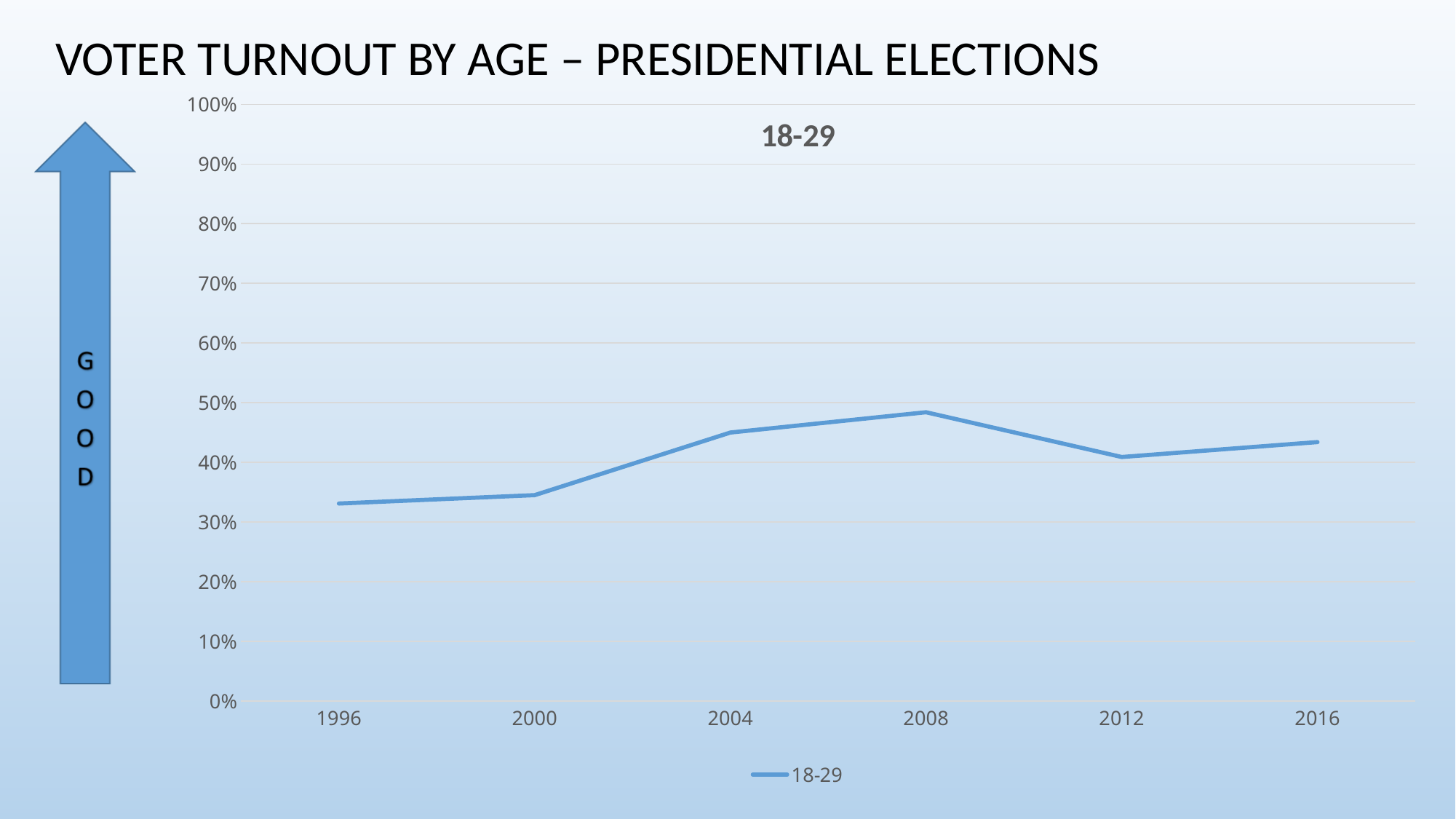
Which election year has the highest voter turnout for the 18-29 group? 2008 Does voter turnout rise or fall from 1996 to 2008? rise Which year has the higher voter turnout, 2012 or 2016? 2016 What age group does the chart's series represent? 18-29 Is the voter turnout for 2008 greater or less than 50%? less Is the voter turnout for 2004 greater or less than 40%? greater Is the voter turnout for 1996 greater or less than 40%? less What kind of chart is shown on the slide? line chart How many series does the legend list? 1 How many election years are plotted on the x axis? 6 Which year has the higher voter turnout, 2008 or 2012? 2008